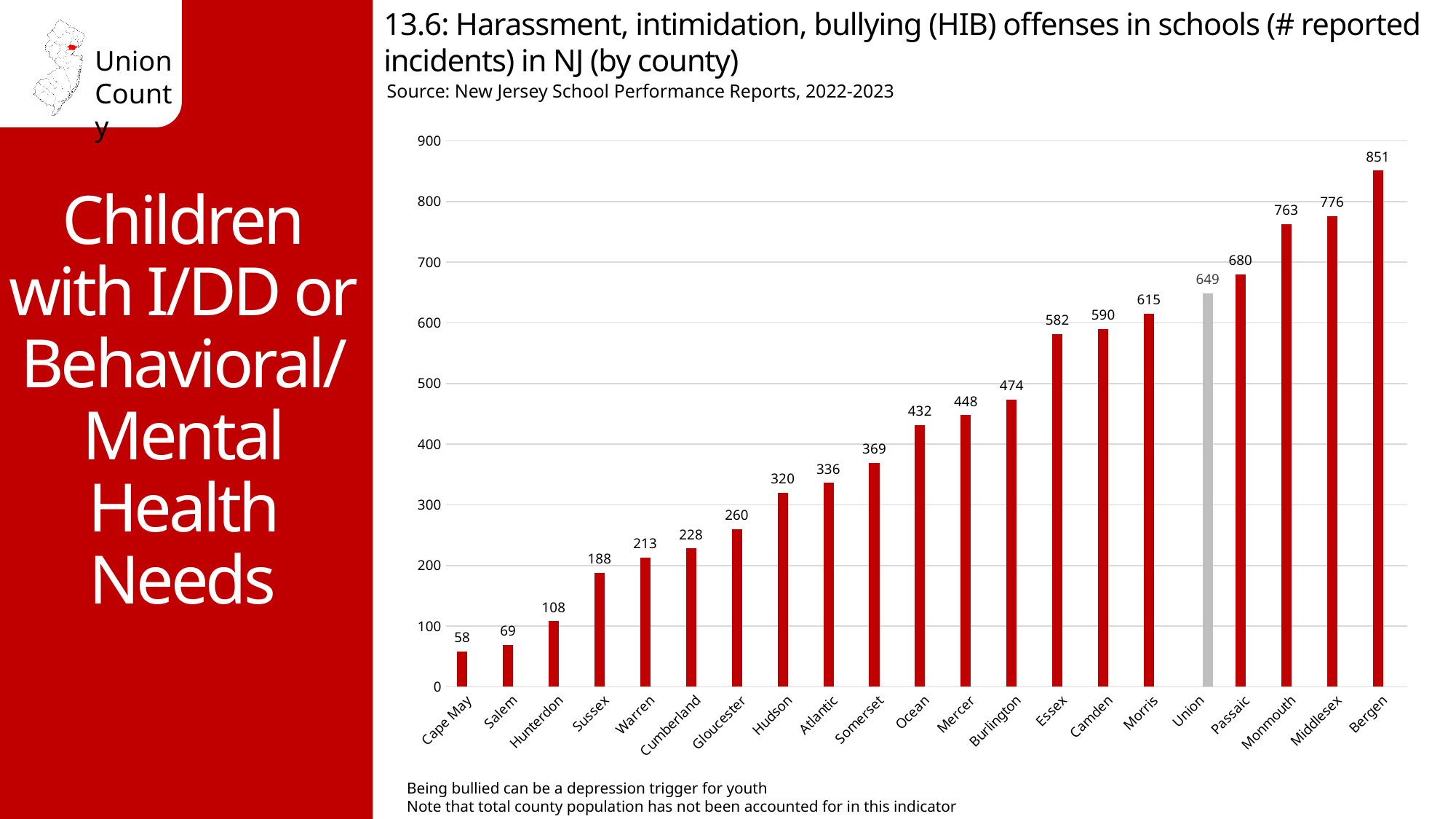
What kind of chart is shown on the slide? Bar chart Which county has more reported HIB incidents, Passaic or Morris? Passaic What is the number of reported HIB incidents for Union County? 649 How many counties are shown on the chart? 21 Which county has the lowest number of reported HIB incidents? Cape May Which county has the highest number of reported HIB incidents? Bergen What is the difference in reported HIB incidents between Bergen and Union counties? 202 Do the values rise or fall moving from left to right along the x axis? Rise Is the value for Monmouth greater or less than 700? greater What is the number of reported HIB incidents for Bergen County? 851 What is the number of reported HIB incidents for Hudson County? 320 Which county's bar is shown in grey instead of red? Union